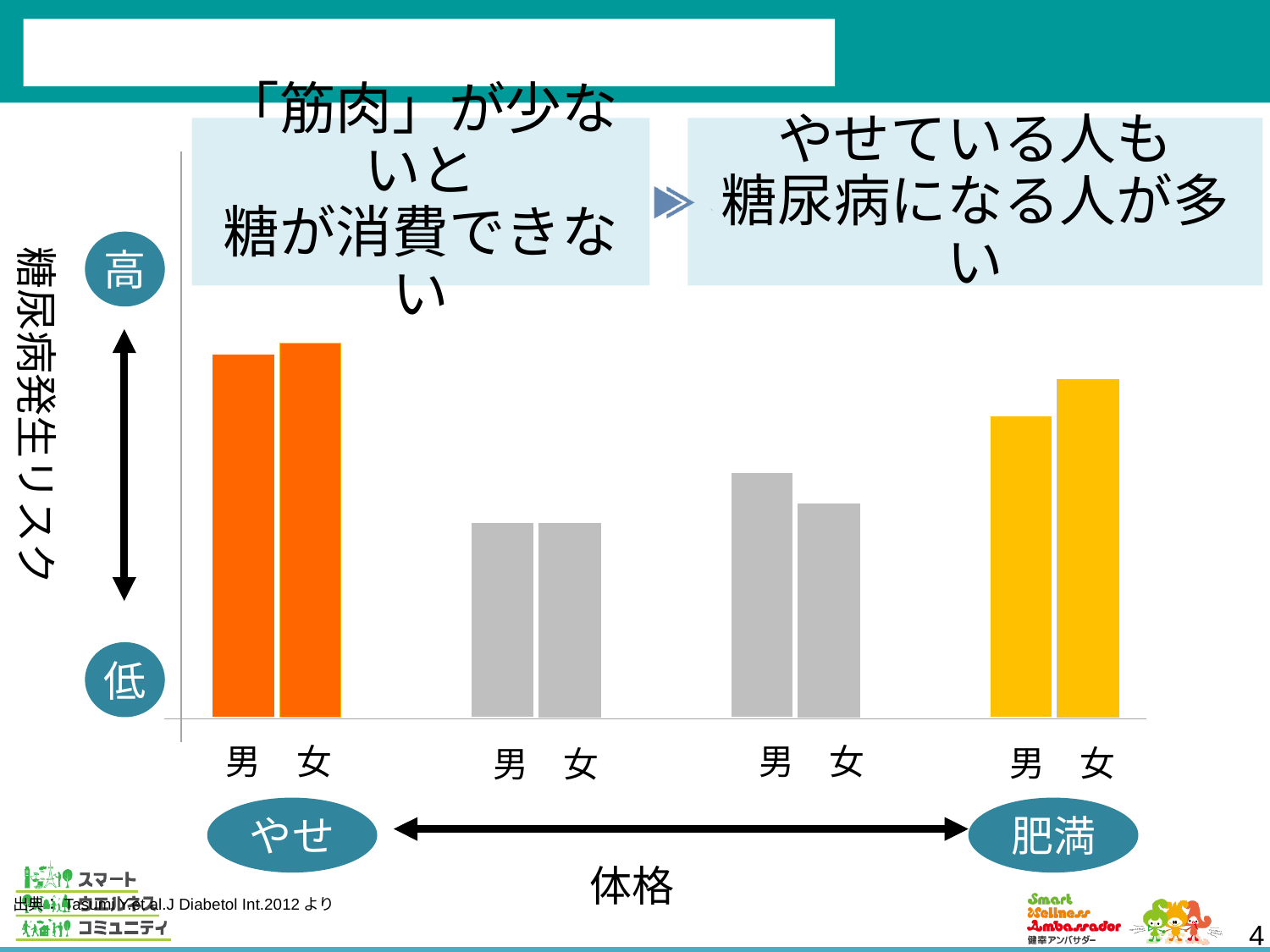
In the 肥満 (obese) group, which bar is taller, 男 or 女? 女 What kind of chart is shown on the slide? bar chart How many bars are plotted in the chart? 8 Which group of bars shows the lowest diabetes risk? the second group from the left Moving from やせ to 肥満 along the x axis, does the diabetes risk fall steadily, rise steadily, or fall and then rise? fall and then rise Is the 男 bar in the やせ group taller or shorter than the 男 bar in the 肥満 group? taller What does the vertical axis of the chart represent? 糖尿病発生リスク What label is given to the horizontal axis of the chart? 体格 Which group of bars shows the highest diabetes risk? やせ How many groups of bars (body-type categories) are shown along the x axis? 4 In the third group from the left, which bar is taller, 男 or 女? 男